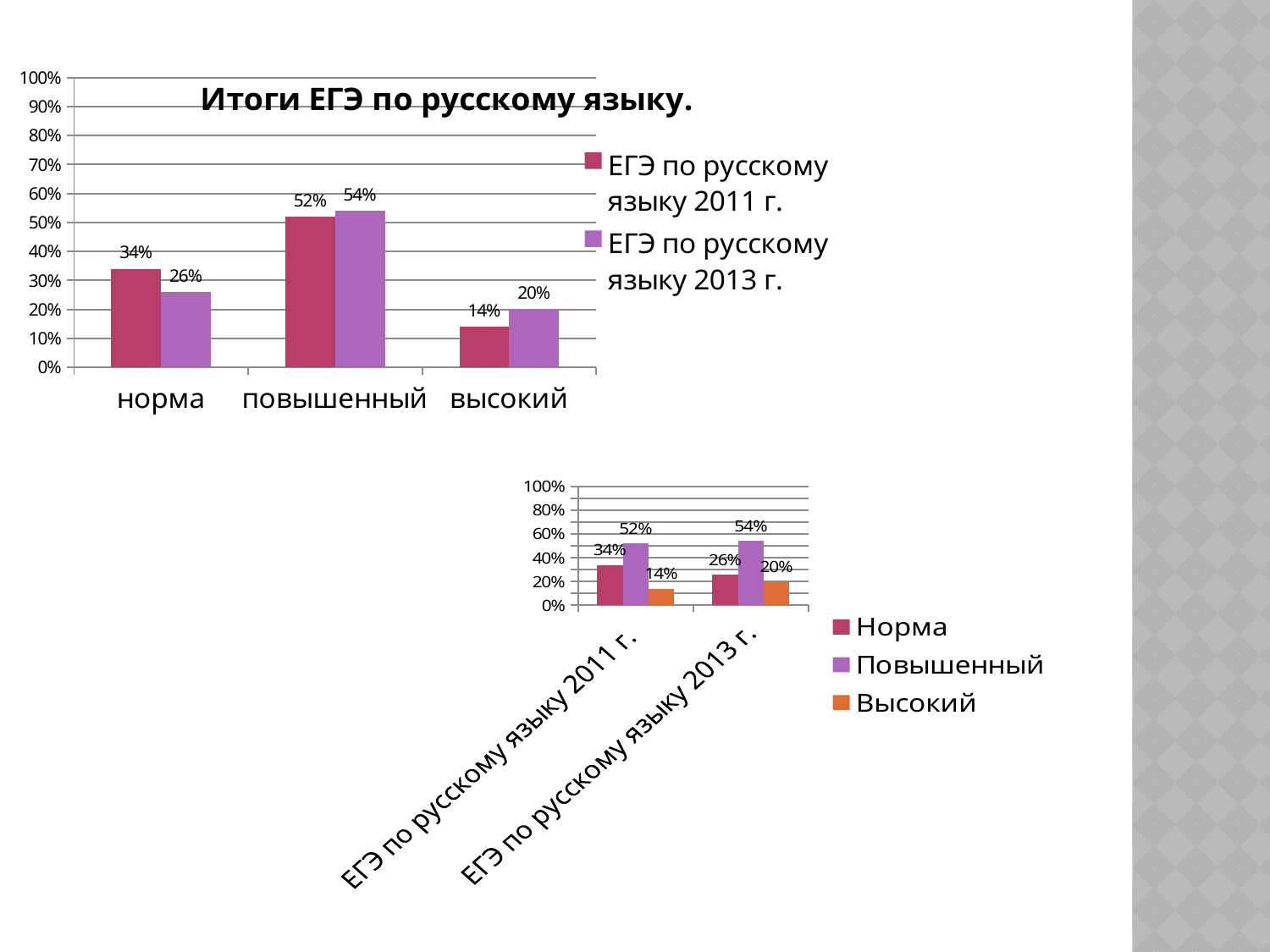
In the top chart titled 'Итоги ЕГЭ по русскому языку.', which category has the lowest value in the series 'ЕГЭ по русскому языку 2011 г.'? высокий In the top chart titled 'Итоги ЕГЭ по русскому языку.', how many series does the legend list? 2 In the bottom chart, what is the value of 'Высокий' for 'ЕГЭ по русскому языку 2011 г.'? 14% In the top chart titled 'Итоги ЕГЭ по русскому языку.', what is the difference between the 2011 and 2013 values for 'норма'? 8% In the bottom chart, what is the difference between 'Повышенный' and 'Норма' for 'ЕГЭ по русскому языку 2013 г.'? 28% In the top chart titled 'Итоги ЕГЭ по русскому языку.', which category has the highest value in the series 'ЕГЭ по русскому языку 2013 г.'? повышенный What kind of chart is the bottom chart on the slide? Bar chart In the top chart titled 'Итоги ЕГЭ по русскому языку.', what is the value for 'норма' in the series 'ЕГЭ по русскому языку 2011 г.'? 34% In the top chart titled 'Итоги ЕГЭ по русскому языку.', how many categories are shown on the x axis? 3 In the top chart titled 'Итоги ЕГЭ по русскому языку.', which is larger for 'повышенный': the 2011 value or the 2013 value? 2013 value (54%) In the top chart titled 'Итоги ЕГЭ по русскому языку.', what is the value for 'высокий' in the series 'ЕГЭ по русскому языку 2013 г.'? 20% In the bottom chart, how many series does the legend list? 3